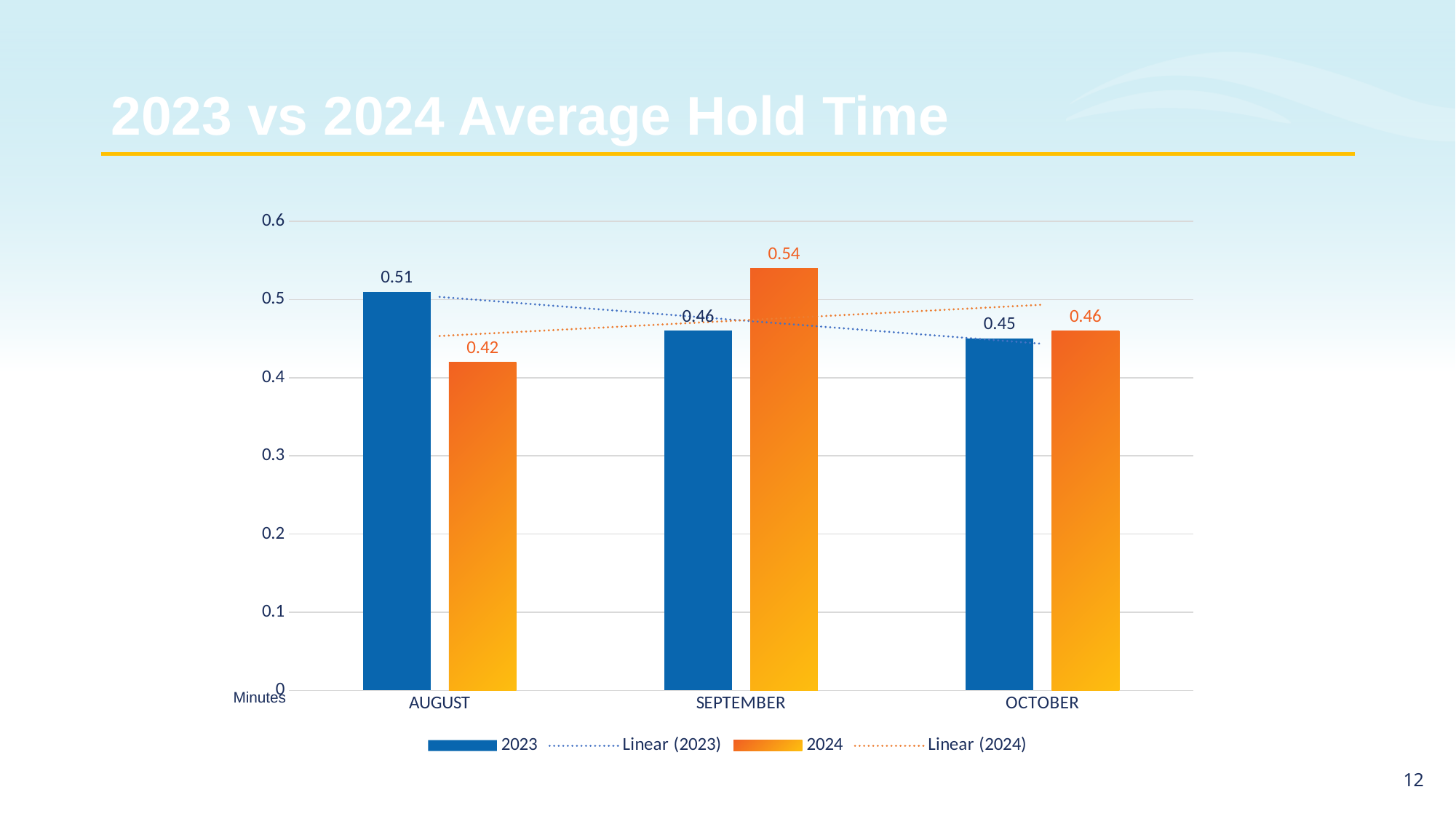
Is the 2024 value for August greater or less than 0.5? less How many entries does the legend list? 4 What is the 2024 average hold time for September? 0.54 What kind of chart is shown on the slide? bar chart Which is larger, the 2023 or the 2024 average hold time for September? 2024 Which month has the lowest 2023 average hold time? October Which month has the highest 2024 average hold time? September What is the difference between the 2023 and 2024 average hold times for August? 0.09 Do the 2023 average hold time values rise or fall from August to October? fall How many months are shown on the x axis? 3 What is the 2024 average hold time for October? 0.46 What is the 2023 average hold time for August? 0.51